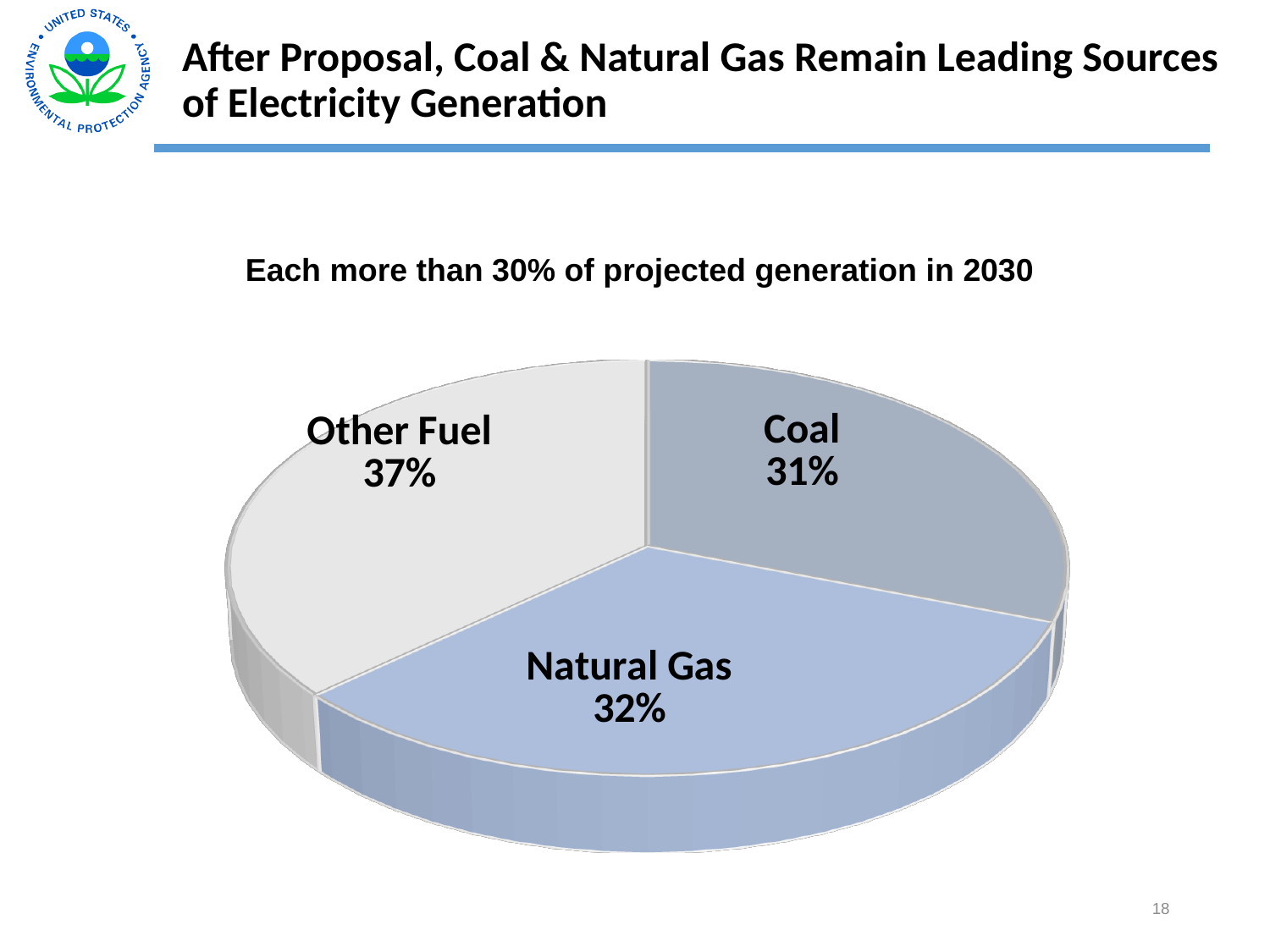
What is the combined share of Coal and Natural Gas? 63% What share of projected 2030 generation does Other Fuel account for? 37% What is the difference in percentage points between Natural Gas and Coal? 1 What share of projected 2030 generation does Coal account for? 31% What share of projected 2030 generation does Natural Gas account for? 32% What is the subtitle text shown above the pie chart? Each more than 30% of projected generation in 2030 Which slice of the pie is the smallest? Coal How many slices does the pie chart have? 3 What kind of chart is shown on the slide? Pie chart Which slice of the pie is the largest? Other Fuel Which has a larger share, Other Fuel or Natural Gas? Other Fuel What is the difference in percentage points between Other Fuel and Coal? 6